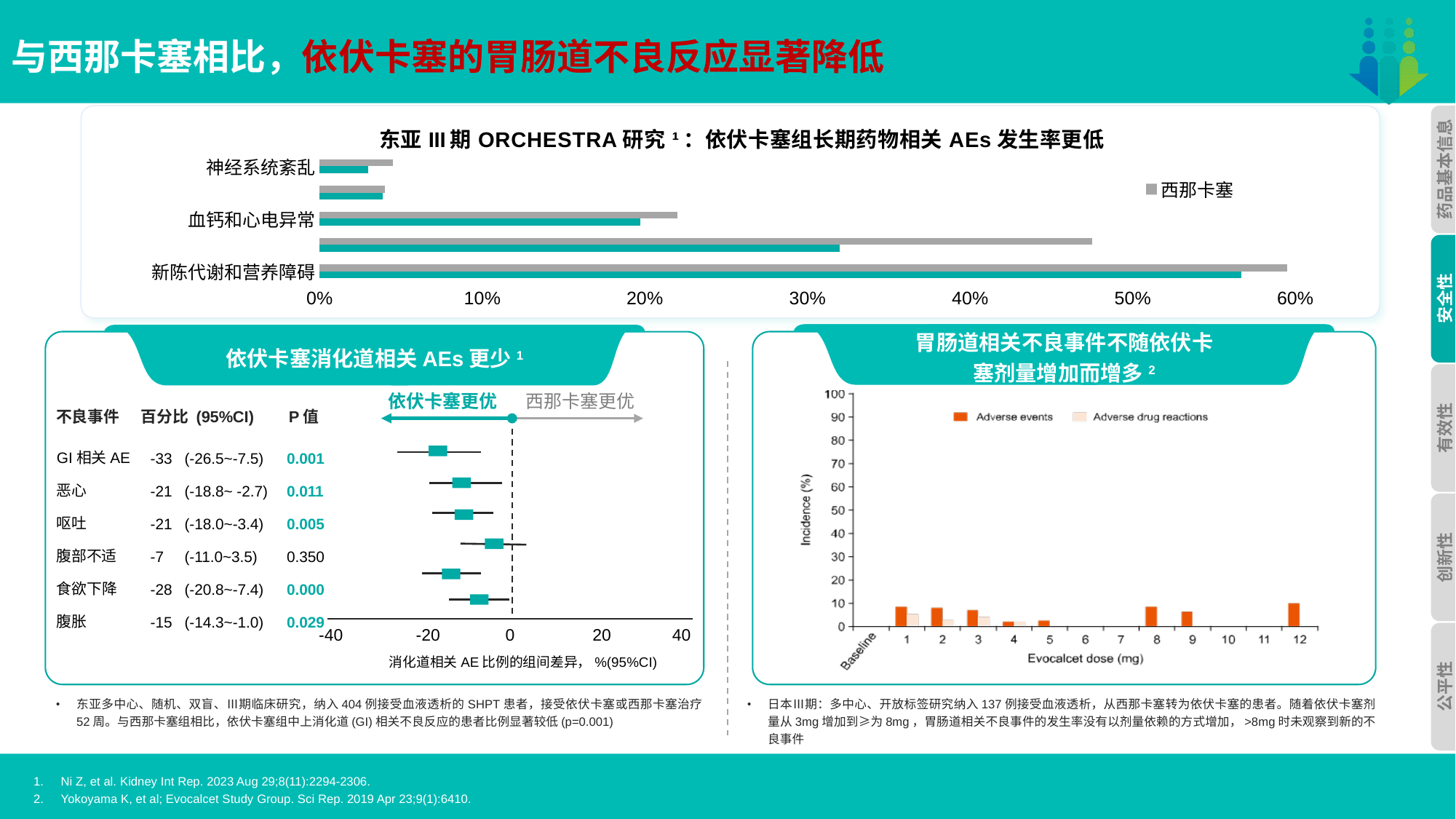
In the bottom-left chart (依伏卡塞消化道相关 AEs 更少), what is the P 值 for 腹部不适? 0.350 In the top chart (东亚 III 期 ORCHESTRA 研究), is the 西那卡塞 value for 新陈代谢和营养障碍 greater or less than 50%? greater In the top chart (东亚 III 期 ORCHESTRA 研究), is the 西那卡塞 value for 神经系统紊乱 greater or less than 10%? less In the top chart (东亚 III 期 ORCHESTRA 研究), is the 西那卡塞 value for 血钙和心电异常 greater or less than 30%? less In the top chart (东亚 III 期 ORCHESTRA 研究), which labeled category has the highest 西那卡塞 value? 新陈代谢和营养障碍 In the bottom-left chart (依伏卡塞消化道相关 AEs 更少), what is the 95%CI for 食欲下降? (-20.8~-7.4) In the bottom-left chart (依伏卡塞消化道相关 AEs 更少), what is the 百分比 difference for GI 相关 AE? -33 In the bottom-right chart (胃肠道相关不良事件不随依伏卡塞剂量增加而增多), how many series does the legend list? 2 In the bottom-left chart (依伏卡塞消化道相关 AEs 更少), how many adverse events (不良事件) are listed? 6 In the top chart (东亚 III 期 ORCHESTRA 研究), which series is listed in the legend? 西那卡塞 What kind of chart is the top chart titled '东亚 III 期 ORCHESTRA 研究'? bar chart